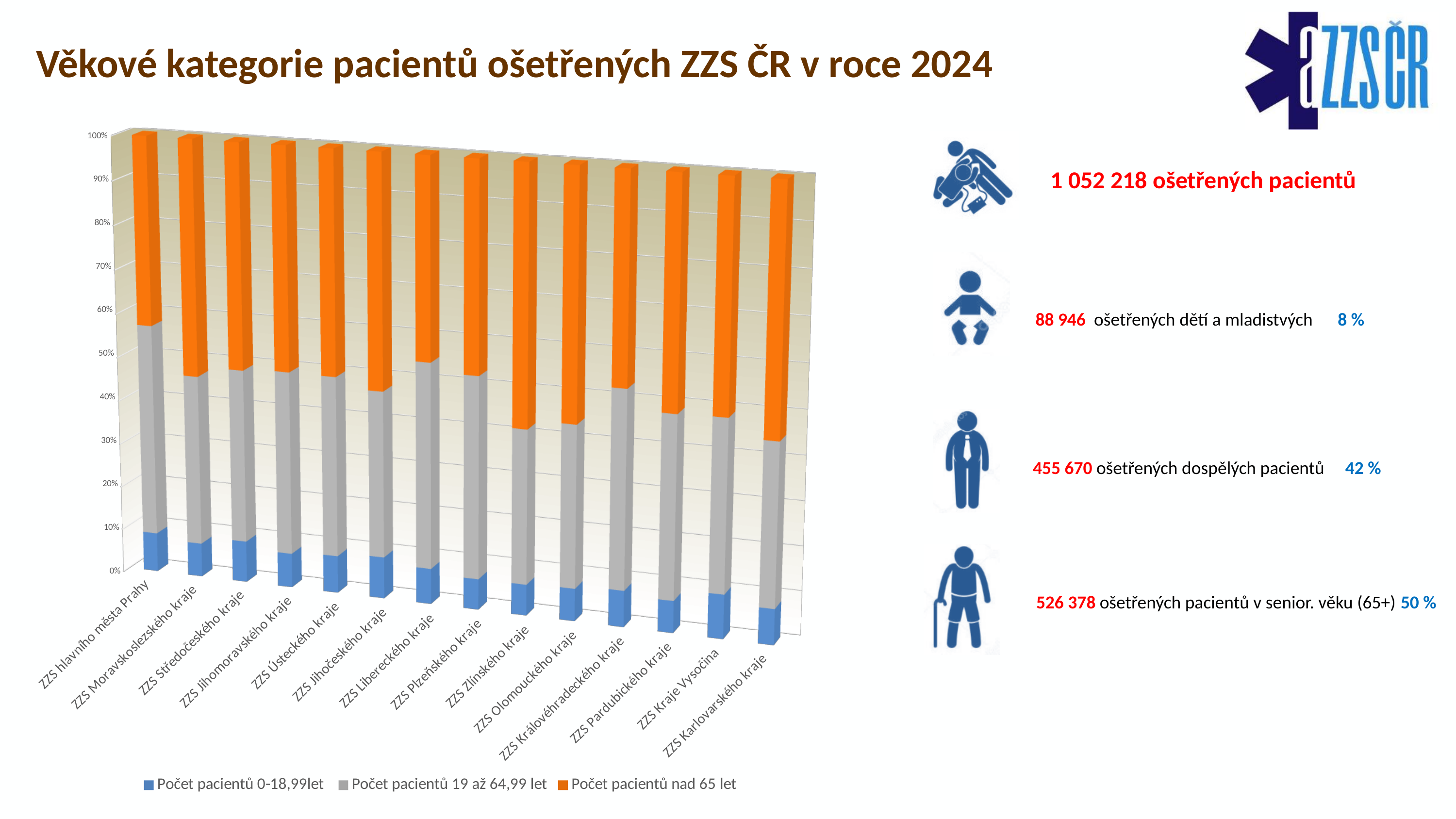
How many series does the chart legend list? 3 Is the share of patients nad 65 let for ZZS hlavního města Prahy greater or less than 50%? less Which series in the chart is shown in orange? Počet pacientů nad 65 let What kind of chart is shown on the slide? Stacked bar chart Which has the larger share of patients nad 65 let: ZZS hlavního města Prahy or ZZS Karlovarského kraje? ZZS Karlovarského kraje Is the share of patients nad 65 let for ZZS Karlovarského kraje greater or less than 50%? greater What is the title of the slide containing the chart? Věkové kategorie pacientů ošetřených ZZS ČR v roce 2024 What is the first category shown on the x axis of the chart? ZZS hlavního města Prahy How many regional ZZS organisations (categories) are shown on the x axis of the chart? 14 Which has the larger share of patients aged 19 až 64,99 let: ZZS hlavního města Prahy or ZZS Karlovarského kraje? ZZS hlavního města Prahy Is the share of patients aged 19 až 64,99 let for ZZS Karlovarského kraje greater or less than 50%? less